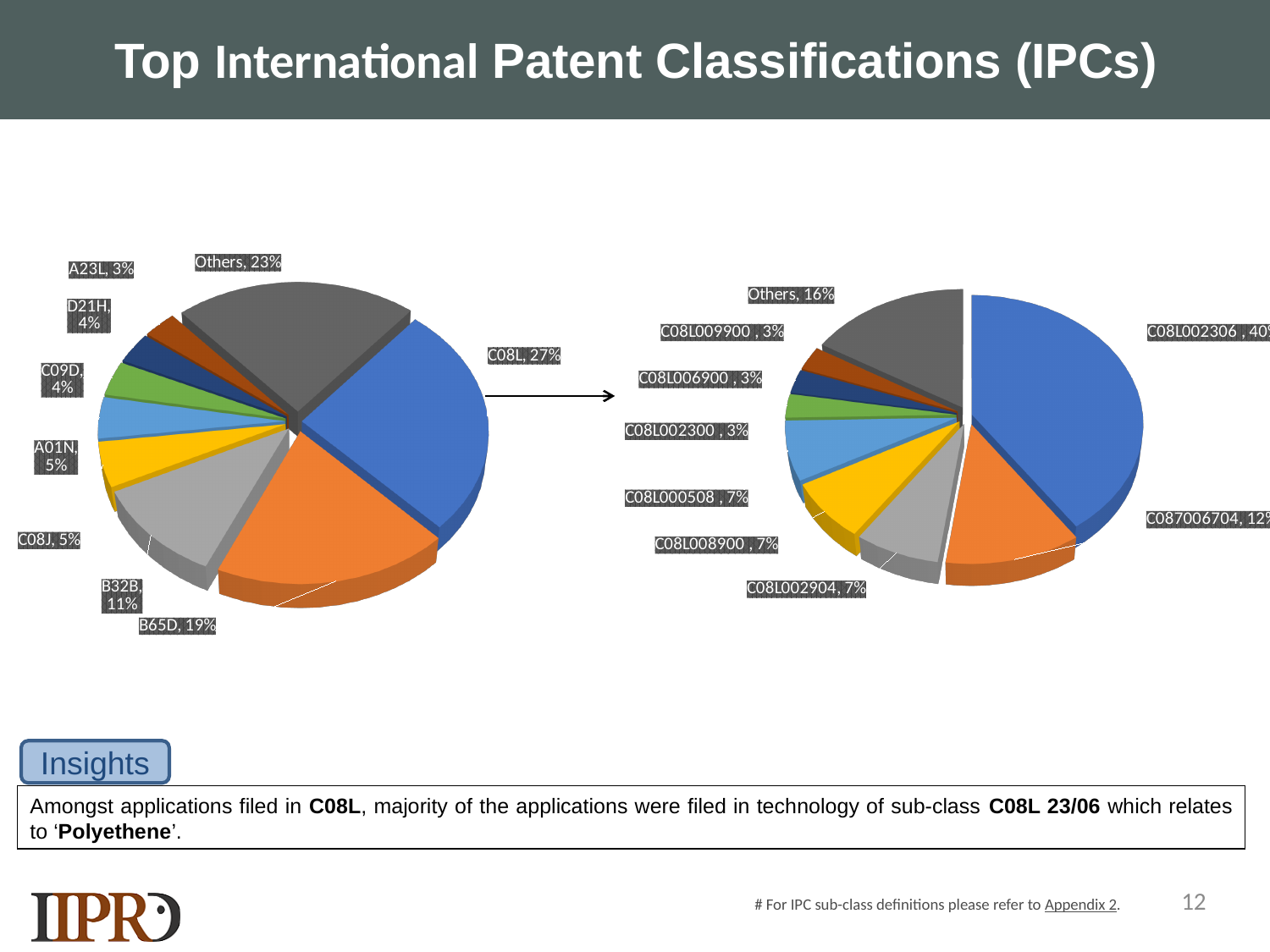
In the left pie chart, what share does B65D have? 19% In the left pie chart, what share does B32B have? 11% What type of chart is used on this slide? Pie chart In the left pie chart, which category has the largest share? C08L In the left pie chart, what is the difference in percentage points between C08L and B65D? 8 In the right pie chart, what share does Others have? 16% In the left pie chart, what share does C08L have? 27% In the right pie chart, which category has the largest share? C08L002306 In the left pie chart, which is larger, B32B or C08J? B32B In the right pie chart, what share does C08L002904 have? 7% In the left pie chart, which named IPC (excluding Others) has the smallest share? A23L How many slices does the left pie chart have? 9